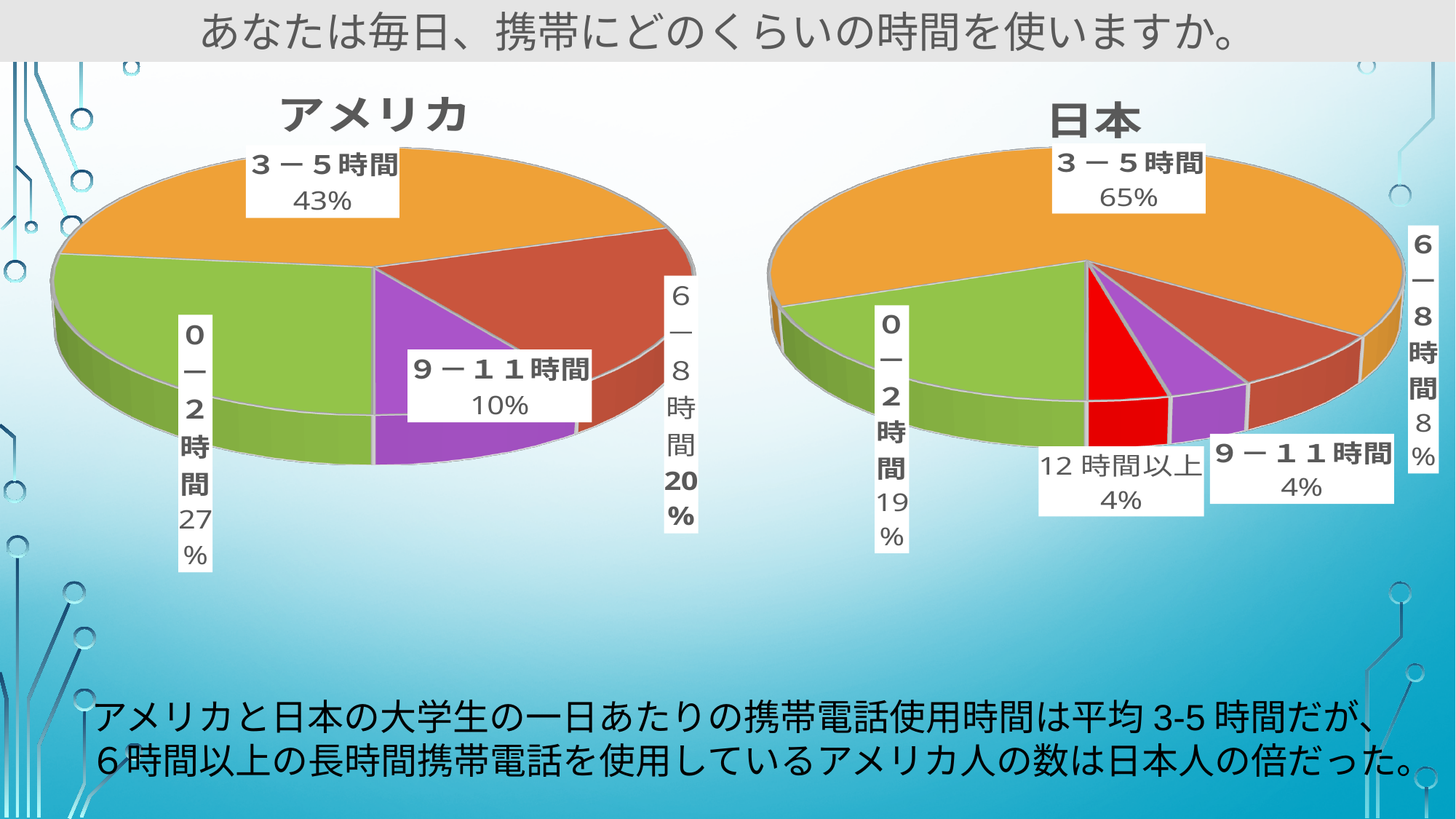
Which chart has the larger share for 6－8時間, アメリカ or 日本? アメリカ In the 日本 chart, how many slices does the pie have? 5 In the 日本 chart, what share is labelled for 6－8時間? 8% In the アメリカ chart, which category has the smallest slice? 9－11時間 In the アメリカ chart, what share is labelled for 9－11時間? 10% In the アメリカ chart, which category has the largest slice? 3－5時間 In the アメリカ chart, how many slices does the pie have? 4 What type of chart is used for the アメリカ chart? pie chart In the アメリカ chart, what share is labelled for 0－2時間? 27% What is the difference between the 3－5時間 share in the 日本 chart and the 3－5時間 share in the アメリカ chart? 22% In the アメリカ chart, what share is labelled for 3－5時間? 43% In the 日本 chart, what share is labelled for 3－5時間? 65%